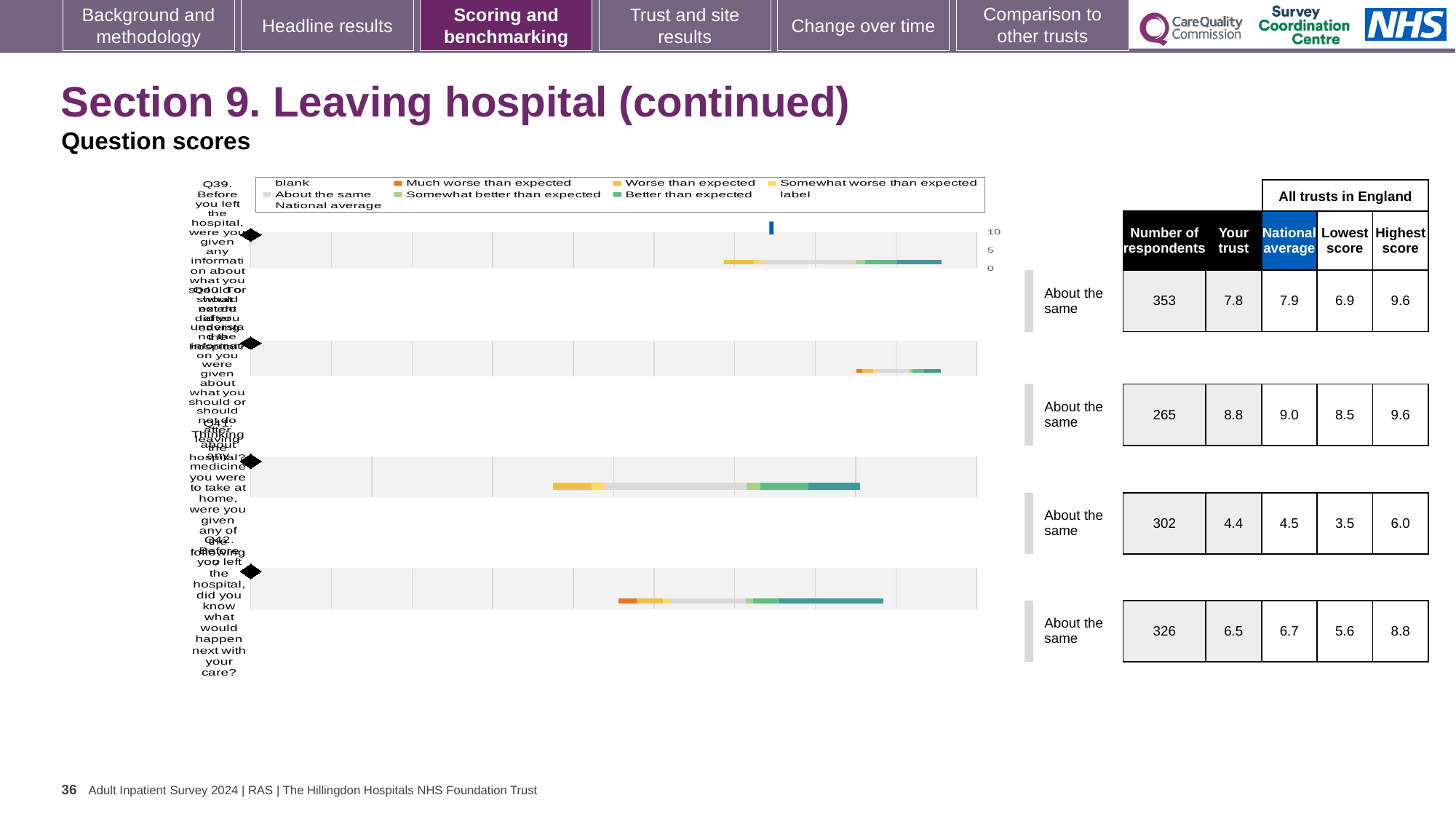
In the table, which row has the highest 'Your trust' score? the second row (8.8) What kind of chart is shown on the left of the slide? bar chart In the table, for the last row, is the 'Your trust' score or the national average larger? National average In the table, what is the number of respondents for the last row (Q42)? 326 In the table, what is the 'Your trust' score for the first row (Q39)? 7.8 In the table, which row has the lowest 'Your trust' score? the third row (4.4) Which legend entry is shown in orange in the chart's legend? Much worse than expected In the table, which row has the most respondents? the first row (353) How many question bars are plotted in the chart? 4 What benchmark category is shown beside each bar in the chart? About the same In the table, what is the national average for the third row? 4.5 In the table, what is the difference between the highest score and the lowest score in the first row? 2.7